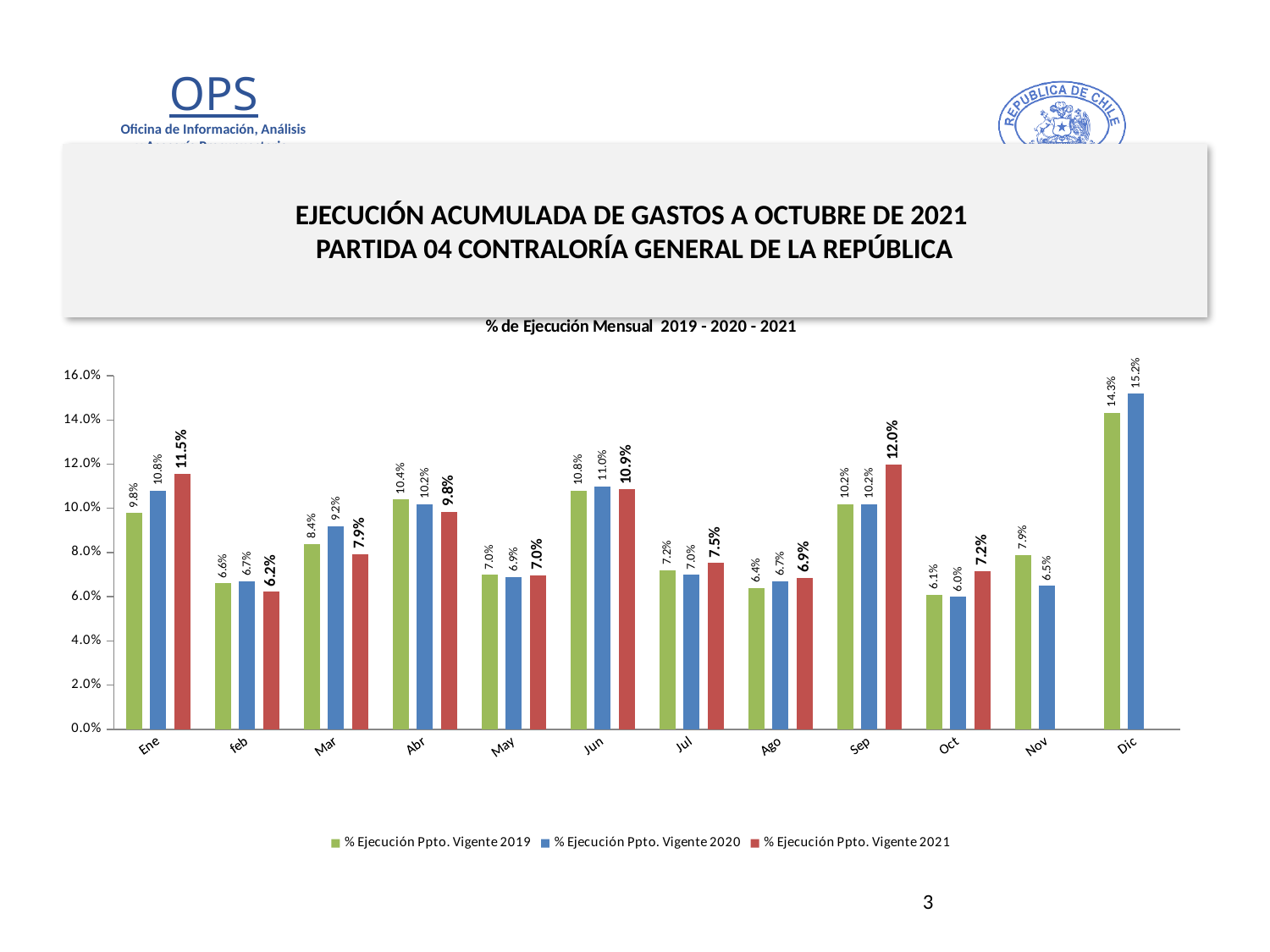
What is the value for % Ejecución Ppto. Vigente 2021 in Sep? 12.0% What is the difference between the 2020 and 2019 values in Dic? 0.9 percentage points Is the value for % Ejecución Ppto. Vigente 2019 in Dic greater or less than 14.0%? greater How many series does the legend list? 3 What is the value for % Ejecución Ppto. Vigente 2020 in Dic? 15.2% What is the value for % Ejecución Ppto. Vigente 2019 in Abr? 10.4% Which month has the highest value for % Ejecución Ppto. Vigente 2021? Sep What kind of chart is shown on the slide? Bar chart In Ene, which is larger: the 2019 value or the 2021 value? 2021 How many months are shown on the x axis? 12 What is the difference between the 2021 and 2019 values in Sep? 1.8 percentage points Which month has the lowest value for % Ejecución Ppto. Vigente 2019? Oct